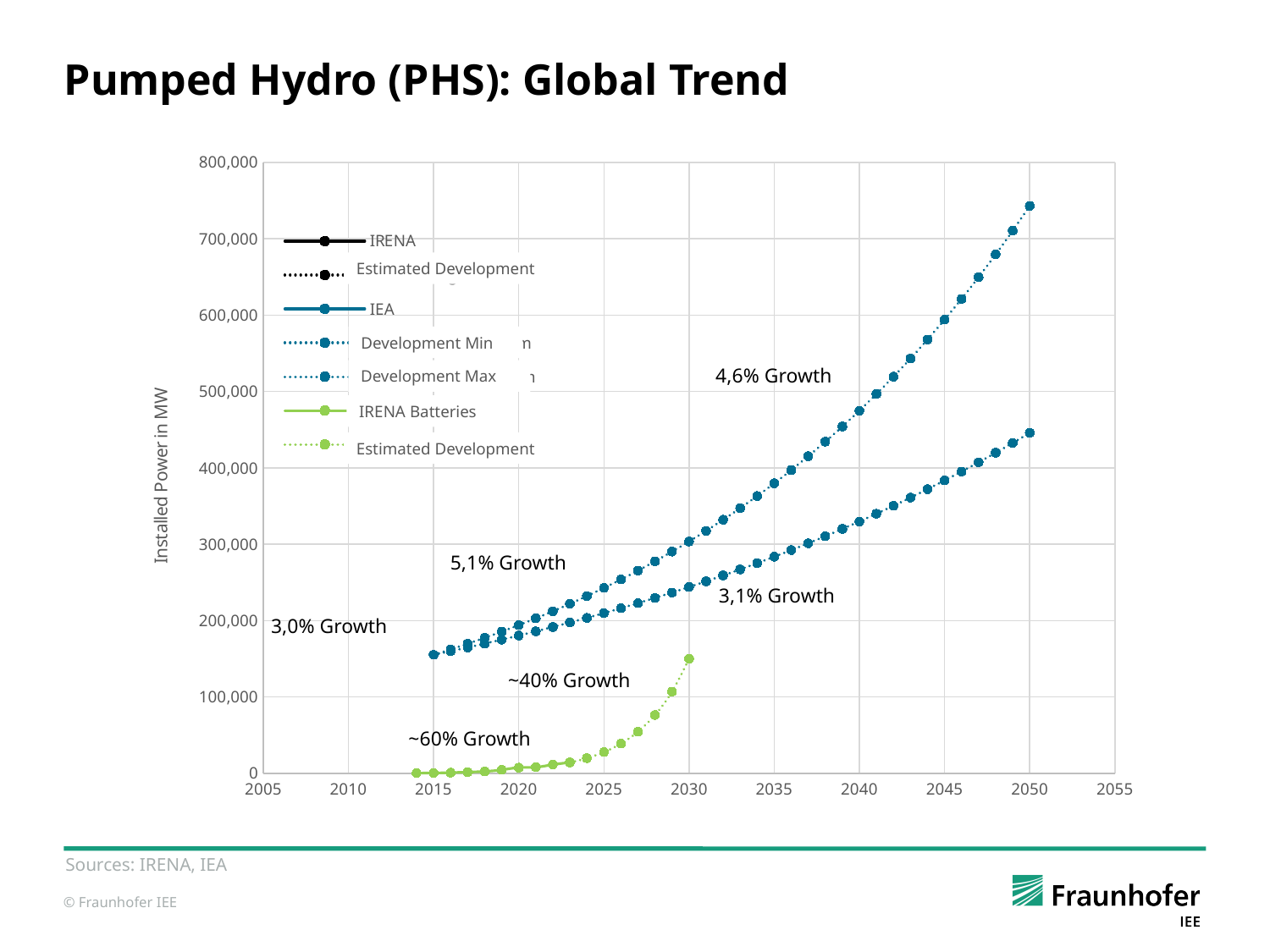
Is the value of the IEA series in 2015 greater or less than 200,000? less What growth rate is annotated next to the upper dotted blue line (Development Max)? 4,6% Growth In 2050, which series has the larger value: Development Max or Development Min? Development Max How many series does the chart legend list? 7 Do the values of the Development Max series rise or fall from 2020 to 2050? rise Is the value of the Development Max series in 2050 greater or less than 700,000? greater What is the label of the y axis? Installed Power in MW Is the value of the Development Min series in 2050 greater or less than 400,000? greater What is the title of the chart on the slide? Pumped Hydro (PHS): Global Trend What kind of chart is shown on the slide? Line chart